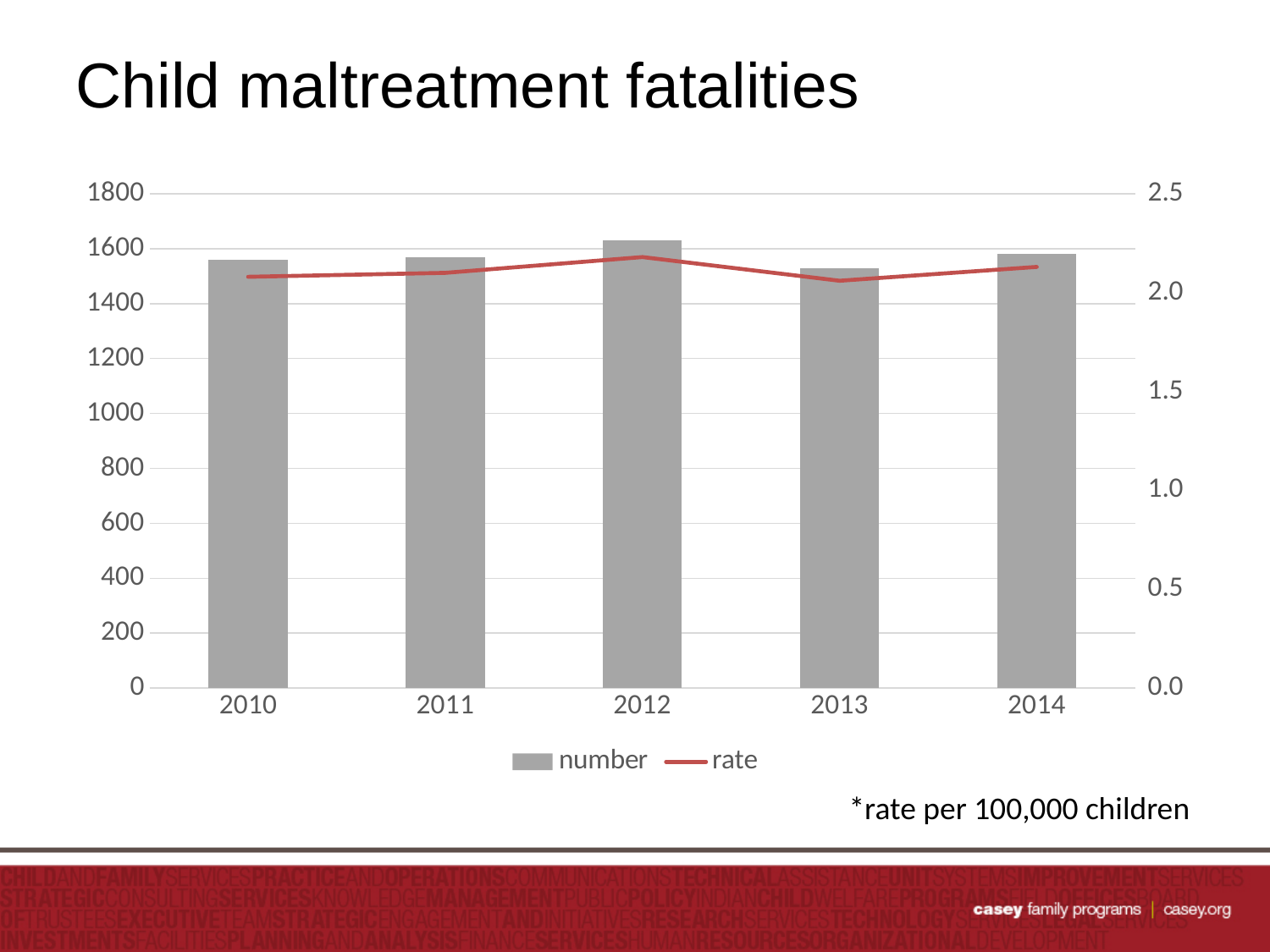
How many years are shown on the x axis? 5 Which year has the larger number, 2012 or 2013? 2012 How many series does the legend list? 2 Is the number for 2013 greater or less than 1600? less According to the footnote, what is the rate measured per? per 100,000 children Which year has the lowest number of child maltreatment fatalities? 2013 Which year has the highest number of child maltreatment fatalities? 2012 Which year has the larger rate, 2012 or 2013? 2012 Is the rate for 2012 greater or less than 2.0? greater Is the number for 2012 greater or less than 1600? greater Which year has the highest rate? 2012 What is the title of the chart? Child maltreatment fatalities